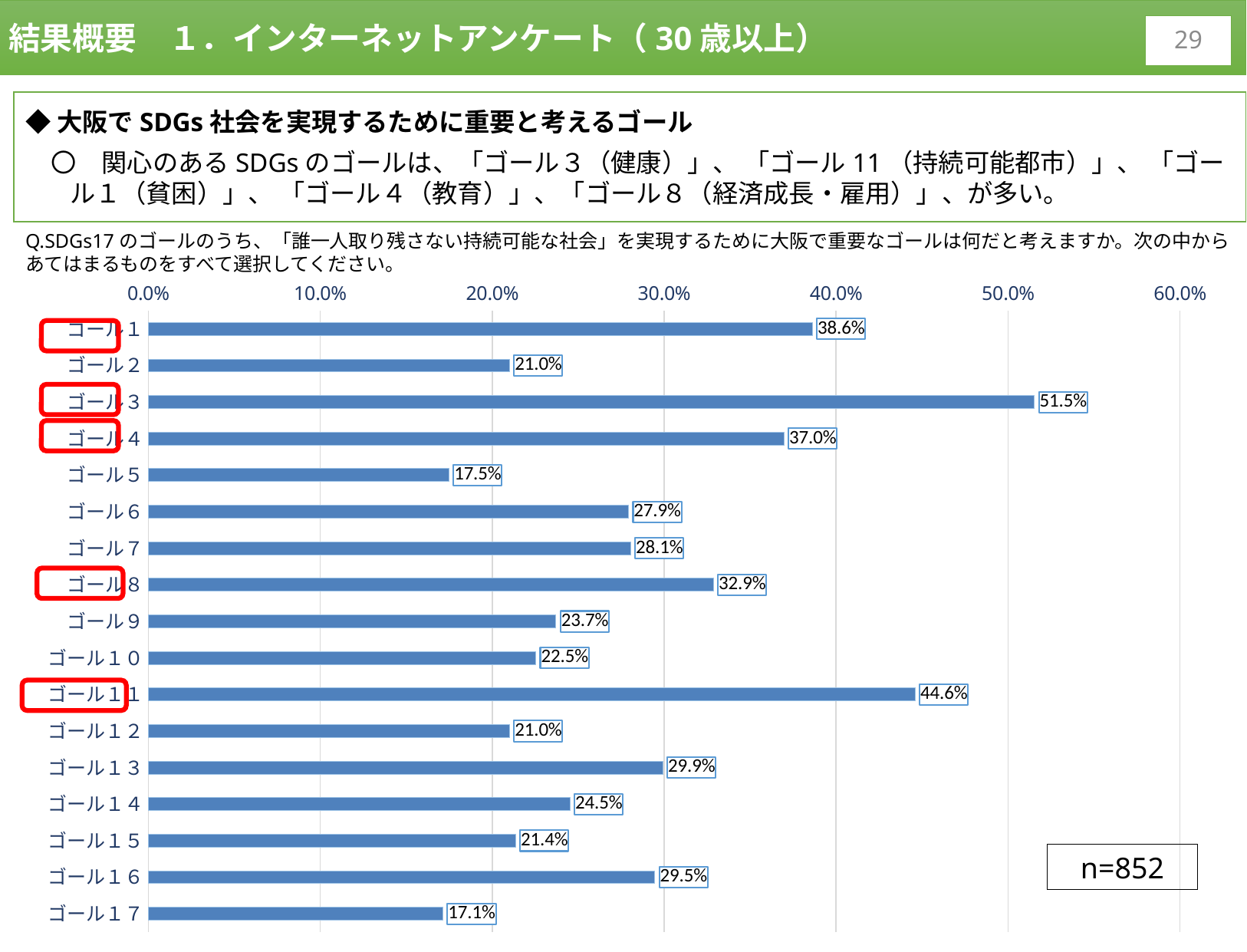
What is the value for ゴール１７? 17.1% What is the value for ゴール１１? 44.6% What is the sample size (n) shown on the chart? n=852 Is the value for ゴール１３ greater or less than 20.0%? greater Which is larger, the value for ゴール１ or the value for ゴール４? ゴール１ Which goal has the lowest value? ゴール１７ Which goal has the highest value? ゴール３ What kind of chart is shown on the slide? bar chart What is the difference between the values for ゴール３ and ゴール１１? 6.9% How many goals (categories) are shown in the chart? 17 What is the value for ゴール８? 32.9% What is the value for ゴール３? 51.5%